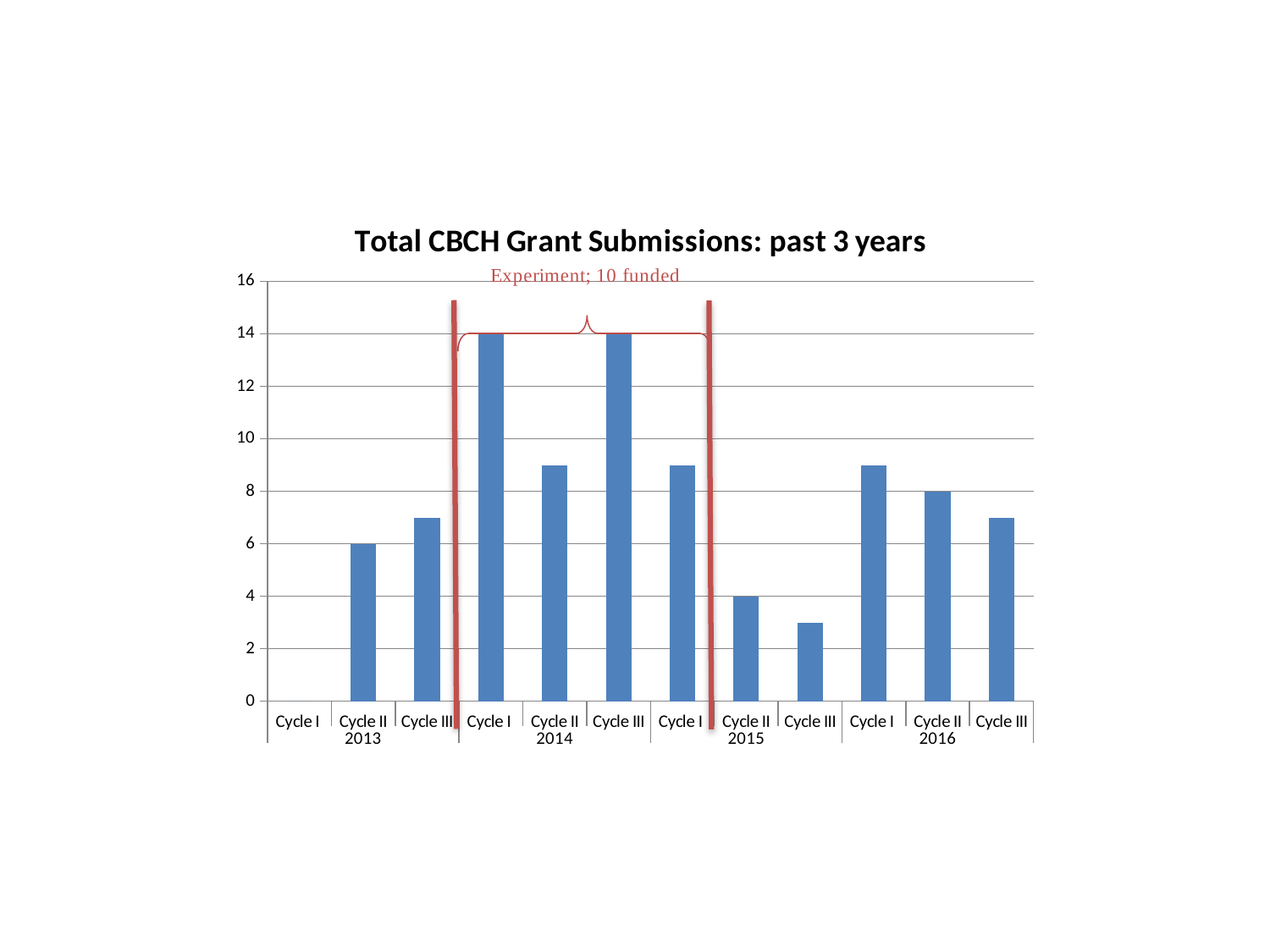
Which cycle has the lowest value within 2015? Cycle III What is the value for Cycle II of 2013? 6 What kind of chart is shown on the slide? bar chart What is the difference between the value for Cycle I of 2014 and the value for Cycle II of 2013? 8 What is the value for Cycle I of 2014? 14 Do the values rise or fall from Cycle I to Cycle III within 2015? fall What is the value for Cycle II of 2015? 4 What is the value for Cycle II of 2016? 8 What is the title of the chart? Total CBCH Grant Submissions: past 3 years What is the highest value reached by any bar in the chart? 14 How many cycle categories are plotted along the x axis? 12 Is the value for Cycle II of 2014 greater or less than 8? greater